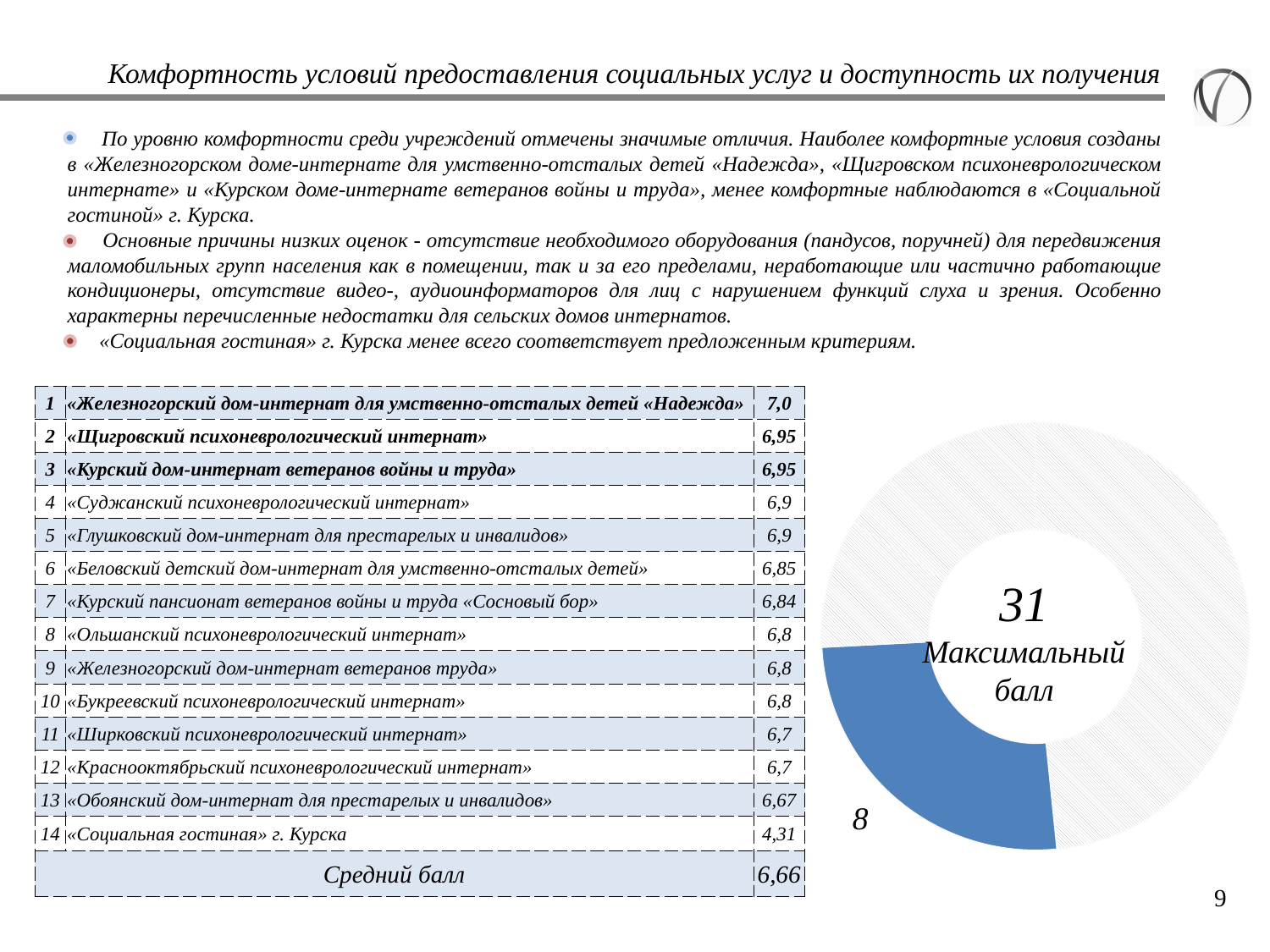
What number is printed in the centre of the doughnut chart? 31 What text accompanies the number in the centre of the doughnut chart? Максимальный балл What value is printed next to the blue slice of the doughnut chart? 8 In the doughnut chart, which is larger: the blue slice or the hatched remainder? The hatched remainder Is the value of the blue slice in the doughnut chart greater or less than 10? less What kind of chart is shown on the right side of the slide? Doughnut (pie) chart